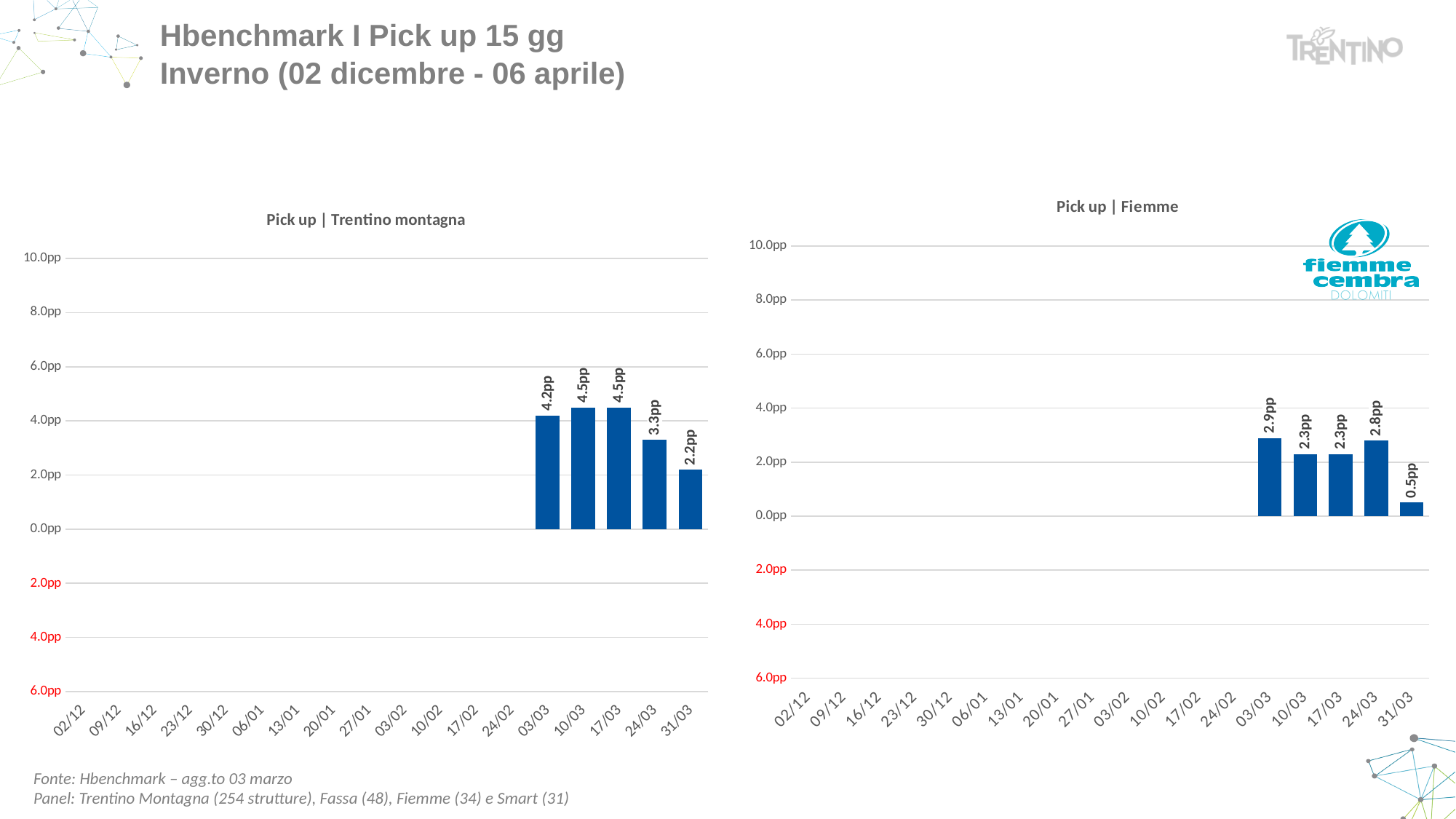
In the 'Pick up | Fiemme' chart, how many dates have a plotted bar? 5 What kind of chart is 'Pick up | Fiemme'? bar chart In the 'Pick up | Trentino montagna' chart, what is the value for 03/03? 4.2pp In the 'Pick up | Trentino montagna' chart, which date has the lowest plotted value? 31/03 In the 'Pick up | Fiemme' chart, what is the value for 10/03? 2.3pp In the 'Pick up | Fiemme' chart, what is the value for 31/03? 0.5pp In the 'Pick up | Trentino montagna' chart, what is the difference between the values for 03/03 and 31/03? 2.0pp In the 'Pick up | Trentino montagna' chart, what is the value for 24/03? 3.3pp In the 'Pick up | Fiemme' chart, what is the difference between the values for 24/03 and 31/03? 2.3pp In the 'Pick up | Fiemme' chart, which date has the highest value? 03/03 In the 'Pick up | Trentino montagna' chart, is the value for 10/03 greater or less than 4.0pp? greater For 24/03, which chart shows the larger value: 'Pick up | Trentino montagna' or 'Pick up | Fiemme'? Pick up | Trentino montagna